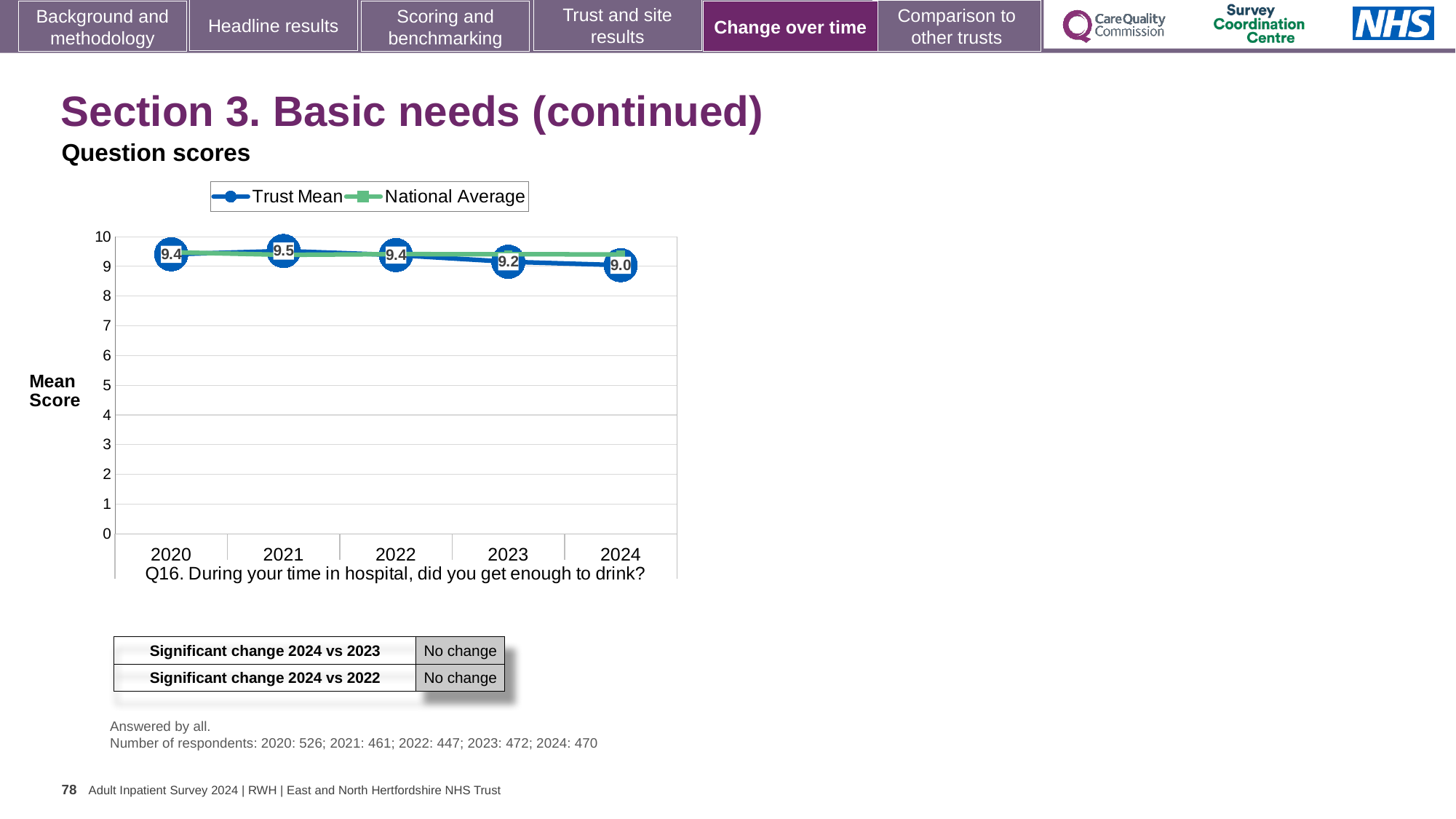
What is the Trust Mean score for 2021? 9.5 In which year is the Trust Mean score lowest? 2024 How many series does the legend list? 2 Which year has the larger Trust Mean score, 2020 or 2024? 2020 Is the National Average value for 2024 greater or less than 9? greater What is the difference between the Trust Mean score in 2021 and in 2024? 0.5 What is the Trust Mean score for 2024? 9.0 What kind of chart is shown on the slide? Line chart In which year is the Trust Mean score highest? 2021 Does the Trust Mean score rise or fall from 2021 to 2024? Fall What is the Trust Mean score for 2023? 9.2 How many years are plotted on the x axis? 5